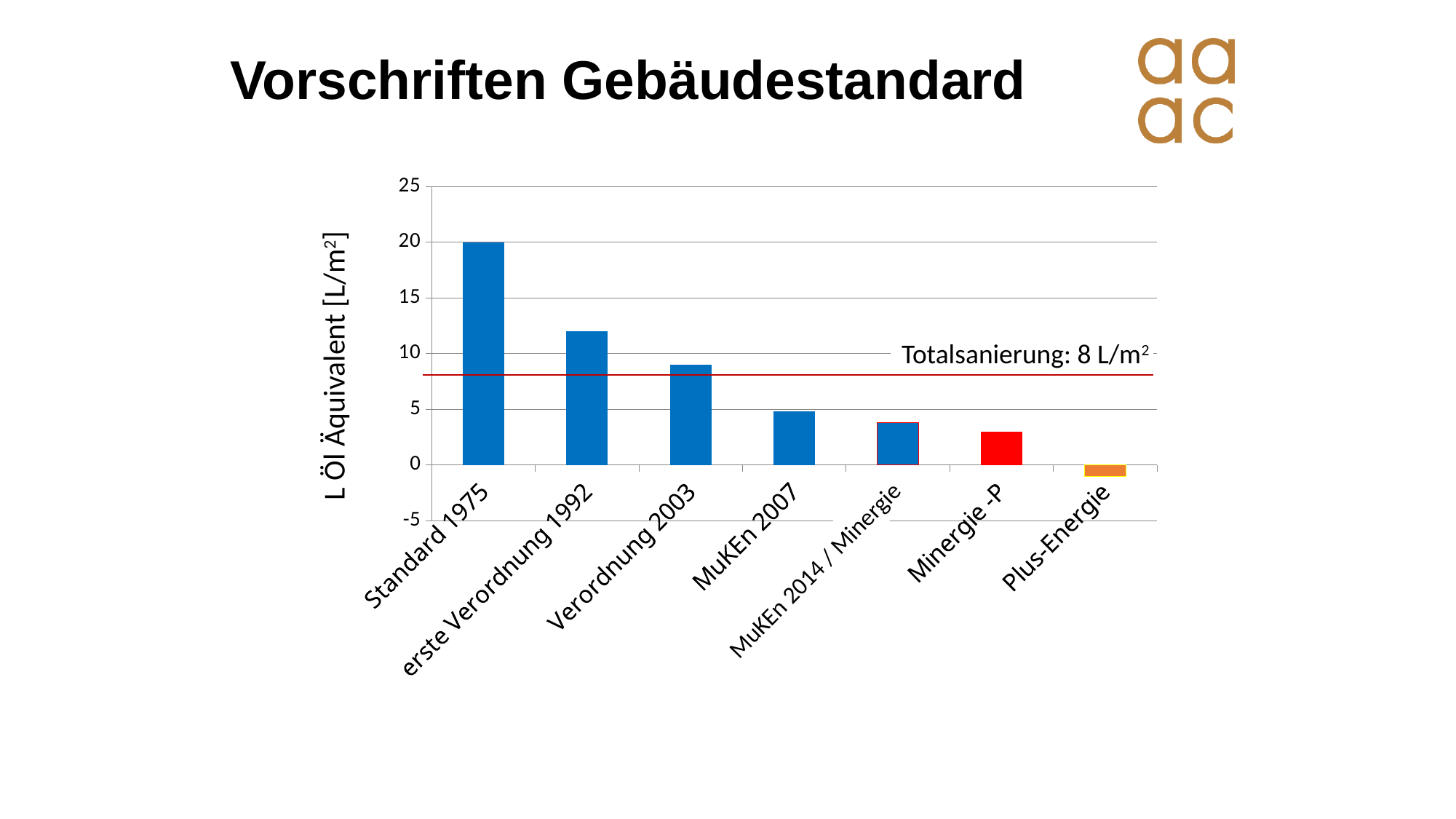
Is the value for Plus-Energie greater or less than 0? less What value does the horizontal reference line labelled Totalsanierung mark? 8 L/m² Which category has the highest value? Standard 1975 What is the value for Standard 1975? 20 Is the value for Minergie -P greater or less than 5? less Do the values rise or fall from left to right along the x axis? fall Which category has the lowest value? Plus-Energie What type of chart is shown on the slide? bar chart Is the value for Verordnung 2003 greater or less than 10? less Which is larger, the value for erste Verordnung 1992 or the value for Verordnung 2003? erste Verordnung 1992 How many categories are shown on the x axis of the chart? 7